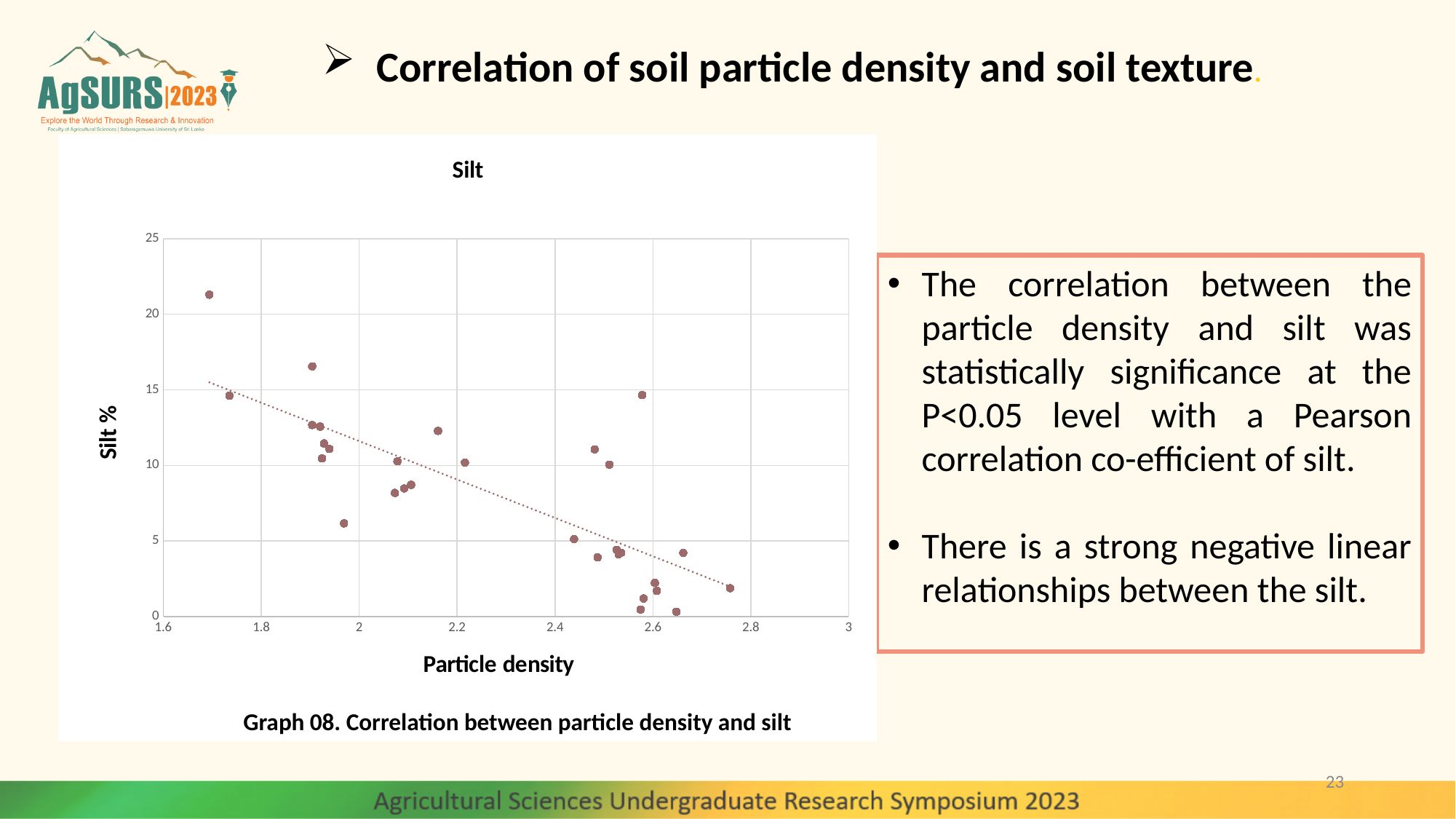
Is the silt % value of the point at a particle density of about 2.44 greater or less than 10? less Which has the higher silt %: the point at a particle density of about 1.7 or the point at a particle density of about 2.76? the point at about 1.7 What is the title of the chart? Silt As particle density increases along the x axis, do the silt % values generally rise or fall? fall What kind of chart is shown on the slide? scatter plot Is the silt % value of the point with the lowest particle density (around 1.7) greater or less than 20? greater What is the maximum value shown on the y axis of the chart? 25 What is the label of the x axis of the chart? Particle density Does the dotted trend line on the chart slope upward or downward from left to right? downward Is the silt % value of the point with the highest particle density (around 2.76) greater or less than 5? less